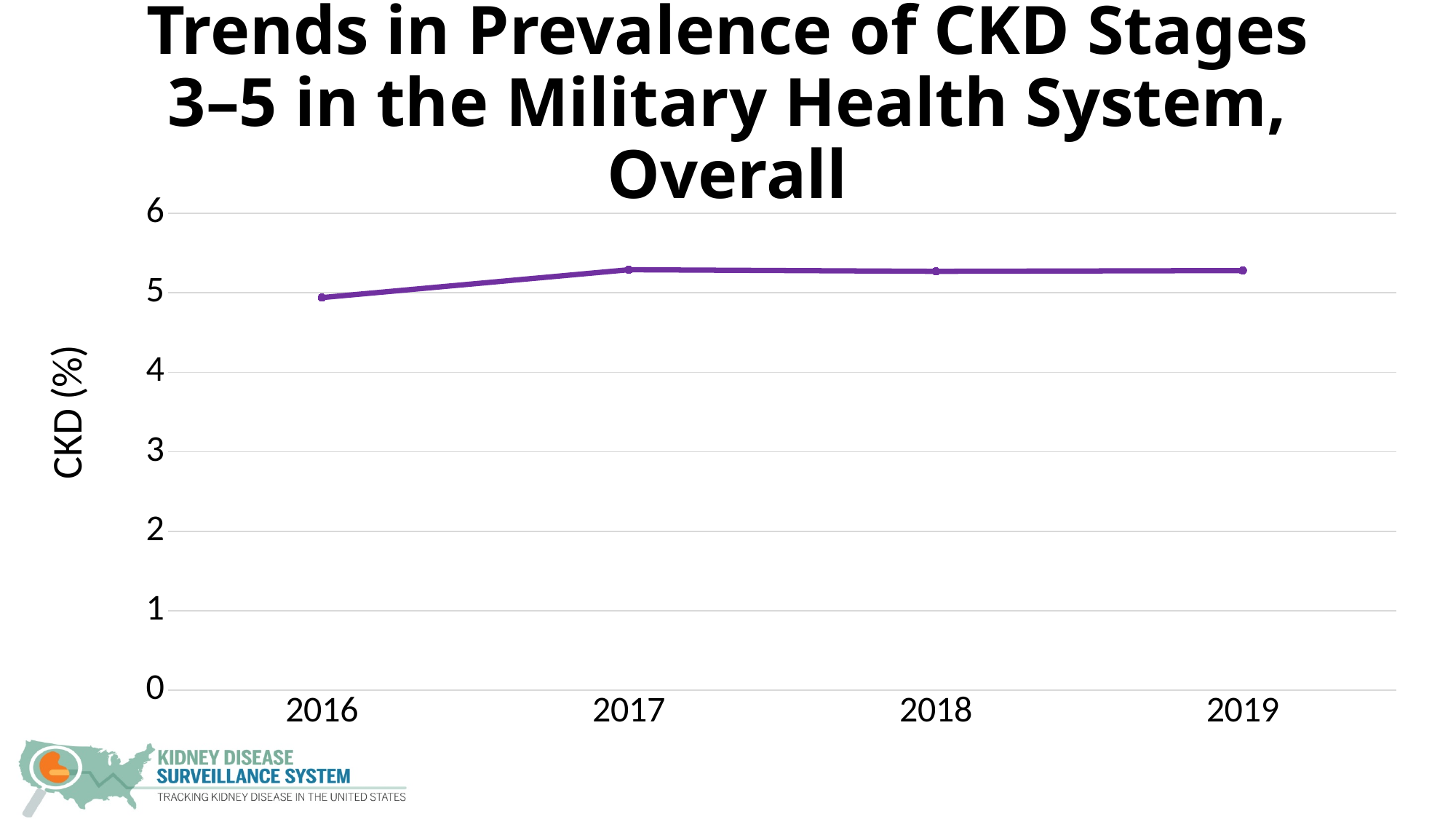
Which is larger, the value for 2016 or the value for 2019? 2019 What is the label on the y axis? CKD (%) How many years are plotted on the x axis? 4 Is the value for 2016 greater or less than 4? greater What is the title of the chart? Trends in Prevalence of CKD Stages 3–5 in the Military Health System, Overall Is the value for 2017 greater or less than 5? greater Does the CKD prevalence rise or fall from 2016 to 2017? rise Which year has the lowest CKD prevalence? 2016 Is the value for 2019 greater or less than 5? greater What kind of chart is shown on the slide? line chart Which is larger, the value for 2016 or the value for 2017? 2017